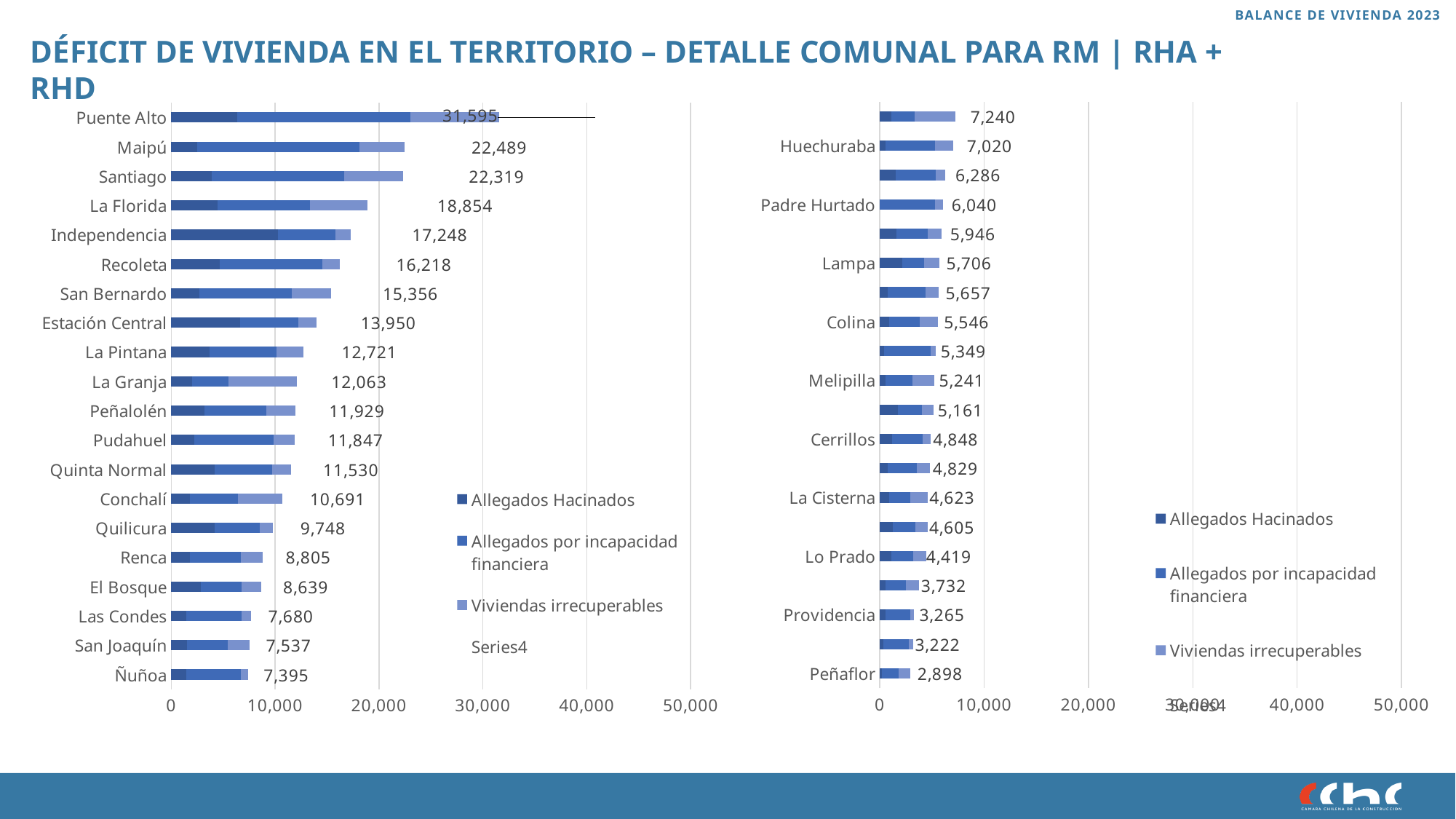
In the left chart, is the total for Puente Alto greater or less than 30,000? greater In the left chart, what is the difference between the totals for Maipú and Santiago? 170 In the left chart, what is the total value shown for Puente Alto? 31,595 How many comunas are shown in the left chart? 20 In the left chart, which comuna has the lowest total? Ñuñoa In the right chart, what is the total value shown for Peñaflor? 2,898 In the left chart, what is the total value shown for Estación Central? 13,950 In the right chart, what is the total value shown for Huechuraba? 7,020 In the right chart, which labelled comuna has the lowest total? Peñaflor In the left chart, which comuna has the highest total? Puente Alto What kind of chart is the left chart? Stacked bar chart In the right chart, which has a larger total, Lampa or Colina? Lampa